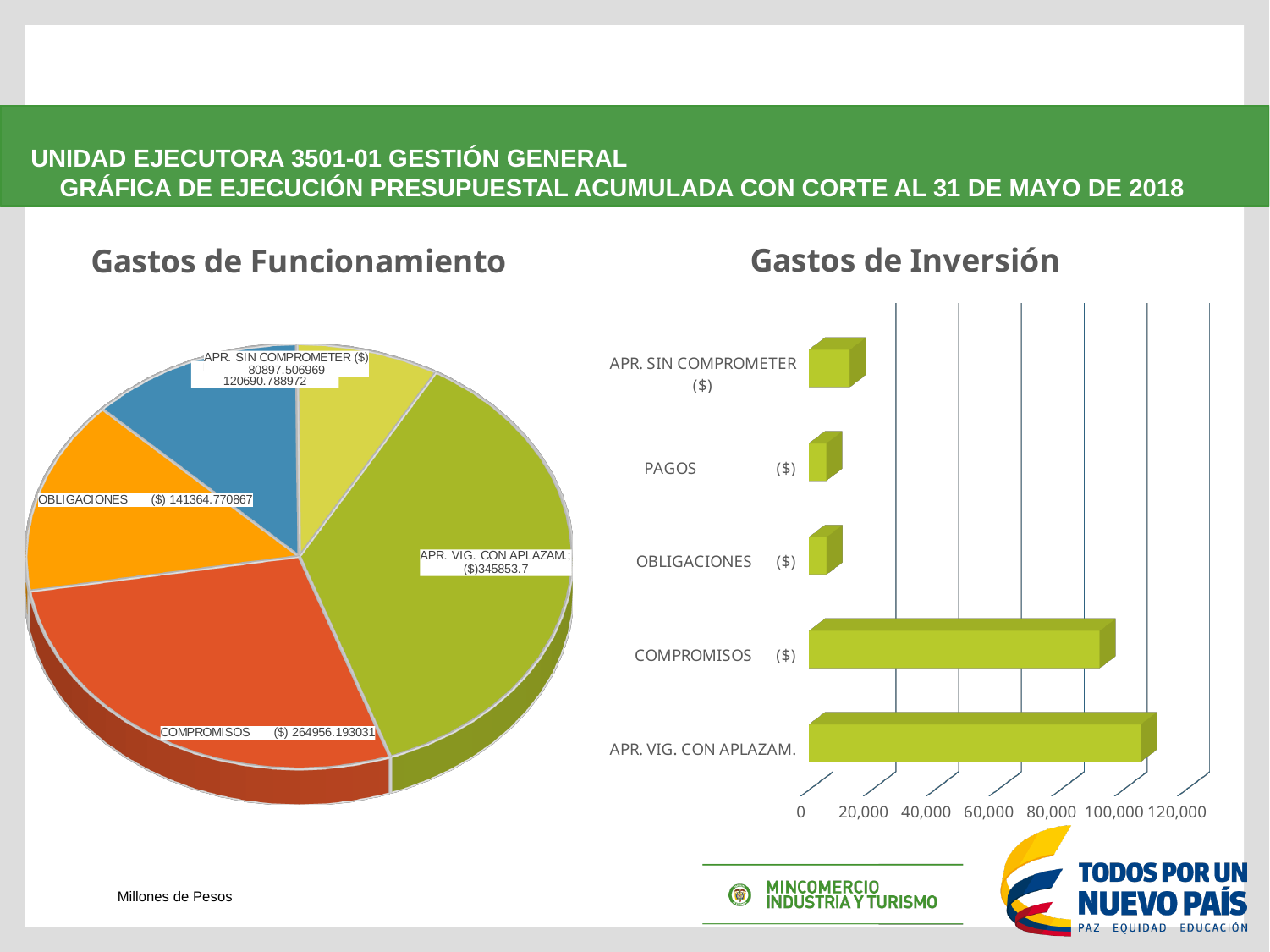
In the Gastos de Inversión chart, which category has the longest bar? APR. VIG. CON APLAZAM. In the Gastos de Inversión chart, is the value for APR. SIN COMPROMETER greater or less than 20,000? less In the Gastos de Funcionamiento pie chart, which category has the largest slice? APR. VIG. CON APLAZAM. What kind of chart is Gastos de Inversión? Bar chart In the Gastos de Inversión chart, is the value for COMPROMISOS greater or less than 80,000? greater In the Gastos de Funcionamiento pie chart, what is the difference between COMPROMISOS and OBLIGACIONES? 123591.422164 In the Gastos de Funcionamiento pie chart, what is the value for APR. SIN COMPROMETER? ($) 80897.506969 In the Gastos de Funcionamiento pie chart, what is the value for OBLIGACIONES? ($) 141364.770867 In the Gastos de Funcionamiento pie chart, which is larger, COMPROMISOS or OBLIGACIONES? COMPROMISOS How many categories are shown in the Gastos de Inversión chart? 5 In the Gastos de Funcionamiento pie chart, what is the value for COMPROMISOS? ($) 264956.193031 In the Gastos de Funcionamiento pie chart, what is the value for APR. VIG. CON APLAZAM.? ($)345853.7